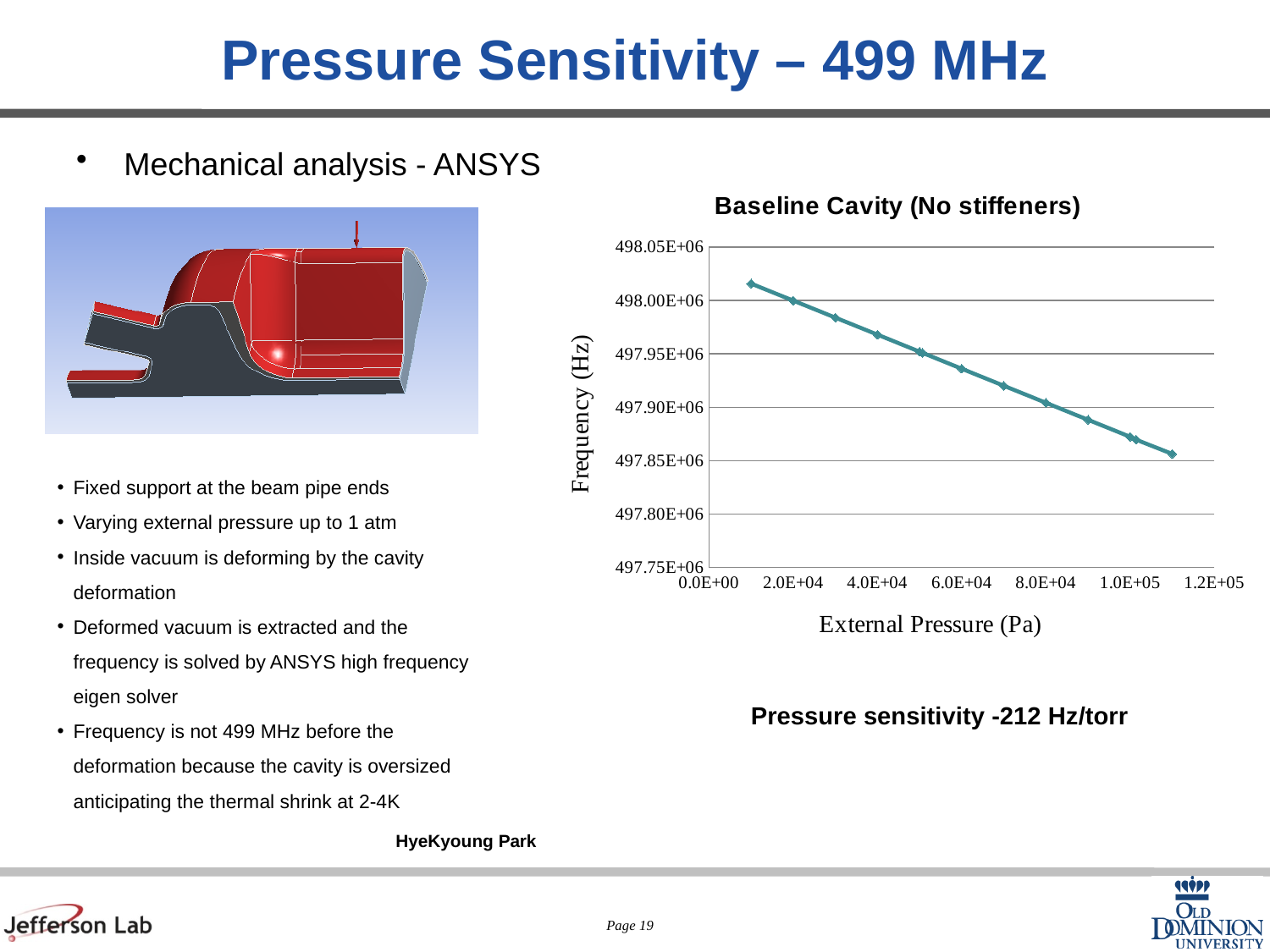
What is the label of the x axis of the chart? External Pressure (Pa) Which has the higher frequency: the point at 2.0E+04 Pa or the point at 1.0E+05 Pa? 2.0E+04 Pa Is the frequency at an external pressure of 1.1E+05 Pa greater or less than 497.90E+06 Hz? less Is the frequency at an external pressure of 4.0E+04 Pa greater or less than 497.95E+06 Hz? greater Is the frequency at an external pressure of 1.0E+05 Pa greater or less than 497.90E+06 Hz? less What kind of chart is shown on the slide? line chart At which external pressure is the plotted frequency highest? 1.0E+04 Pa At which external pressure is the plotted frequency lowest? 1.1E+05 Pa What is the title of the chart on the slide? Baseline Cavity (No stiffeners) Does the frequency rise or fall as external pressure increases along the x axis? fall